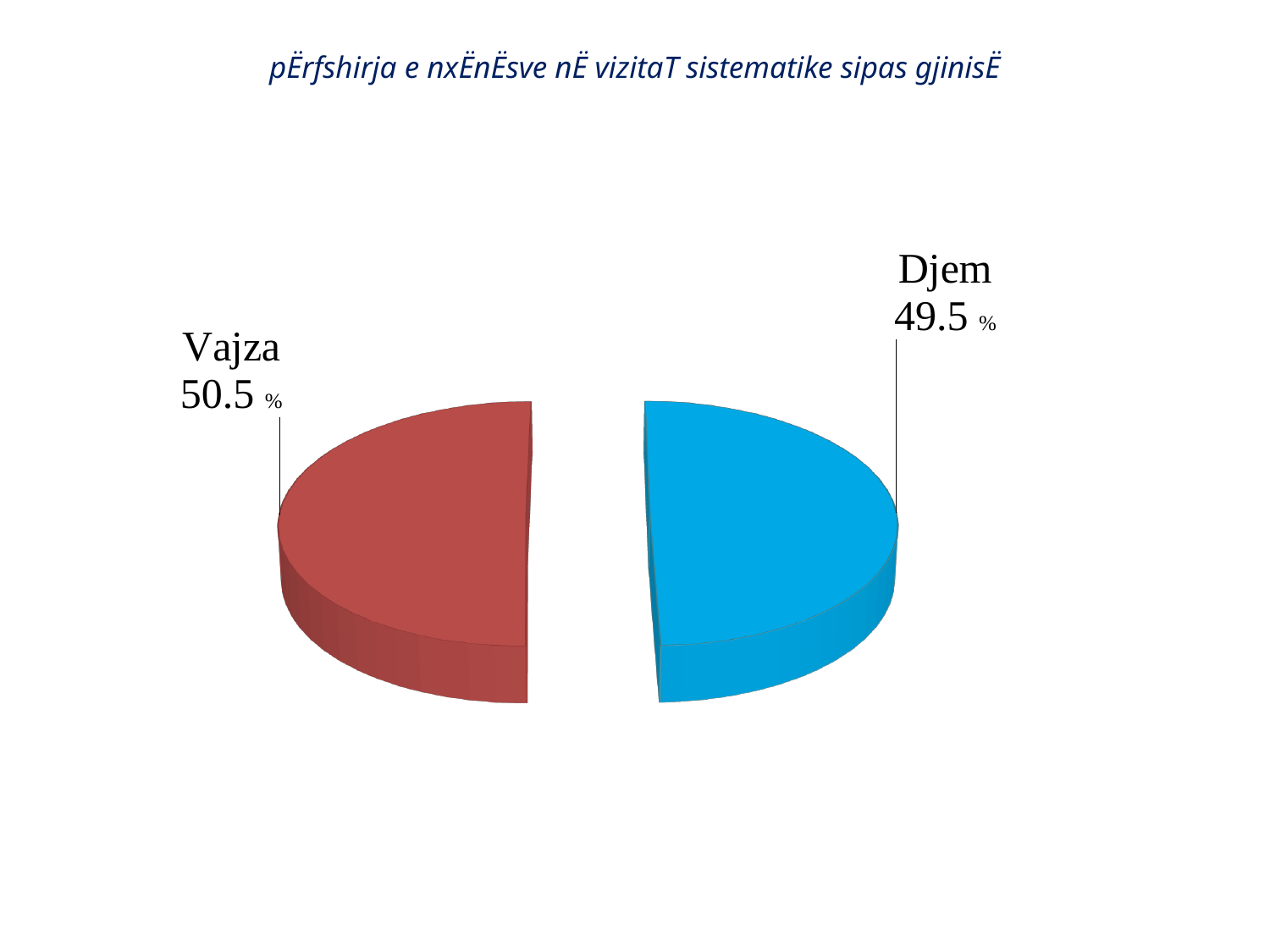
What percentage is shown for Djem? 49.5 % What share of the pie does the Djem slice represent? 49.5 % Is the value for Vajza greater or less than 50 %? greater Which slice of the pie is the smallest? Djem Which slice of the pie is the largest? Vajza Which is larger, the share for Vajza or the share for Djem? Vajza How many slices does the pie chart have? 2 What colour is the Vajza slice? red What percentage is shown for Vajza? 50.5 % What is the difference between the Vajza share and the Djem share? 1 % What kind of chart is shown on the slide? pie chart What colour is the Djem slice? blue